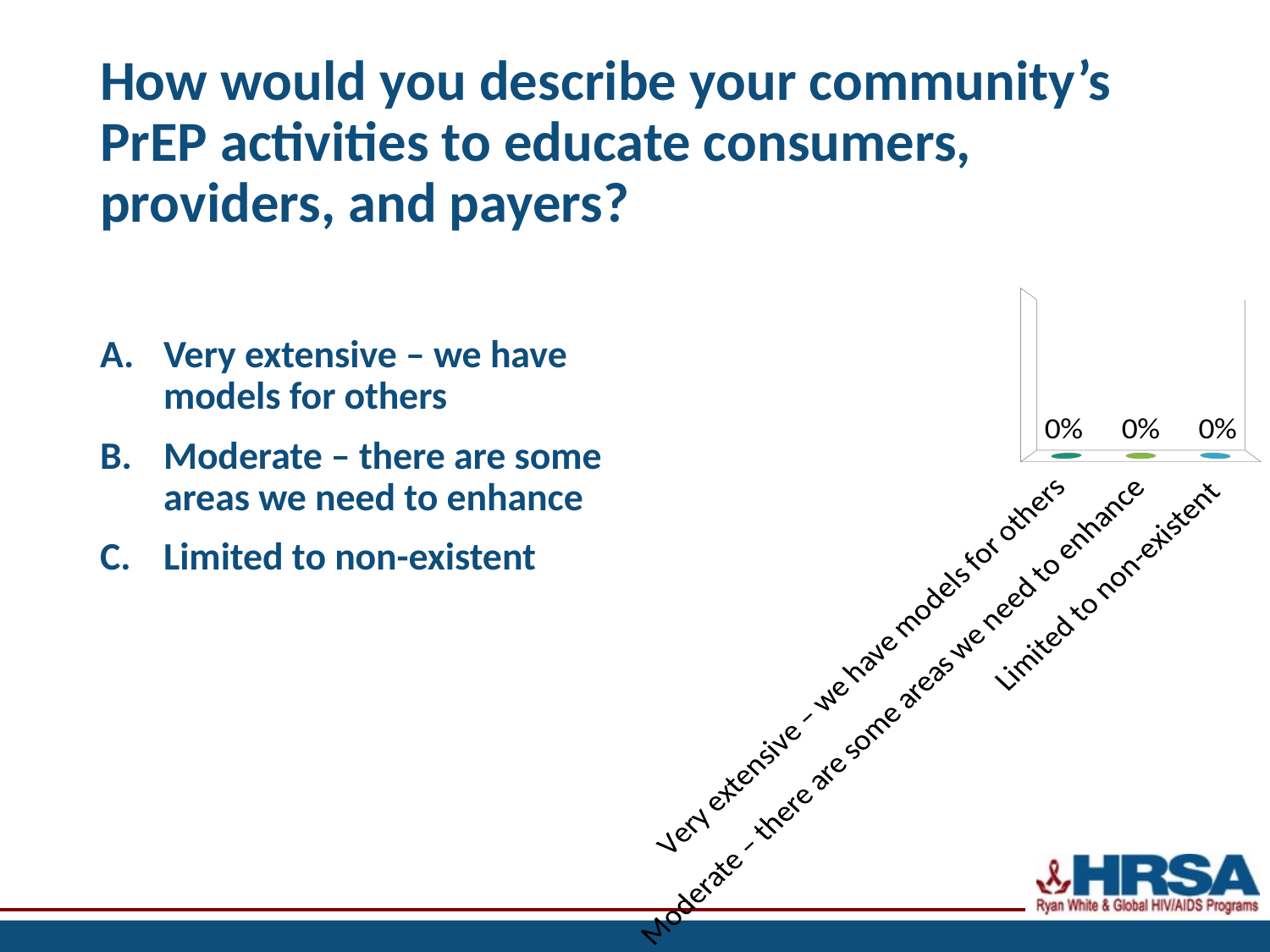
What kind of chart is shown on the slide? Bar chart What is the value shown for "Very extensive – we have models for others"? 0% What is the difference between the values for "Very extensive – we have models for others" and "Limited to non-existent"? 0% What is the value shown for "Limited to non-existent"? 0% Are all three categories on the chart labelled with the same value? Yes, 0% Do the values rise, fall, or stay the same across the categories from left to right? Stay the same How many categories are plotted on the chart? 3 What is the value shown for "Moderate – there are some areas we need to enhance"? 0% Which category label appears furthest to the right on the chart's x axis? Limited to non-existent